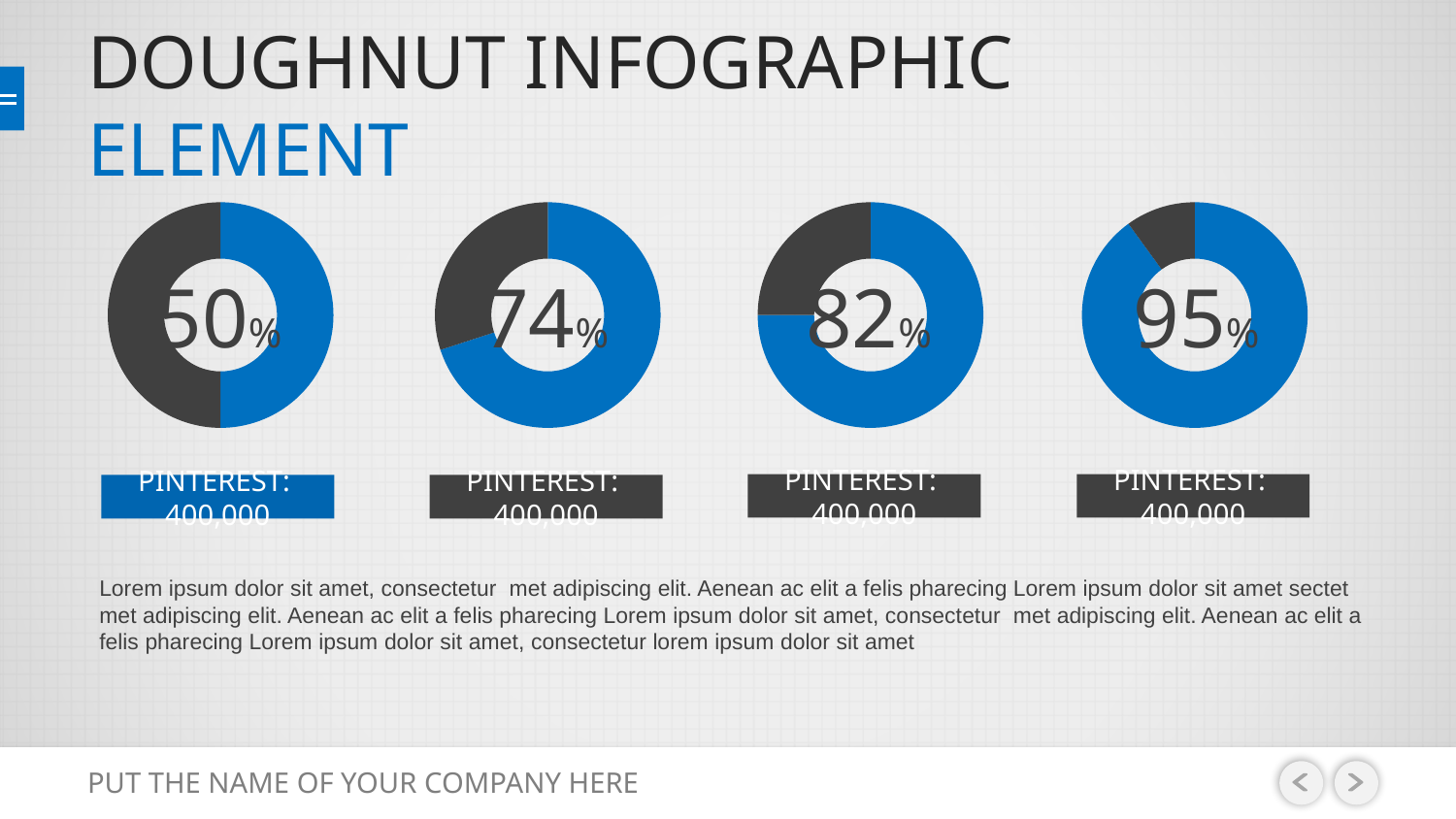
What percentage is shown in the centre of the leftmost doughnut chart? 50% What percentage is shown in the centre of the rightmost doughnut chart? 95% Which doughnut chart shows the lowest percentage? The leftmost one (50%) How many doughnut charts are on the slide? 4 What label appears in the box below each doughnut chart? PINTEREST: 400,000 What is the difference between the percentage in the rightmost doughnut chart and the leftmost doughnut chart? 45 percentage points What percentage is shown in the centre of the third doughnut chart from the left? 82% What percentage is shown in the centre of the second doughnut chart from the left? 74% Which is larger, the percentage in the second doughnut chart or the third doughnut chart? The third (82%) What kind of chart is used on this slide? Doughnut chart Do the percentages in the doughnut charts rise or fall from left to right across the slide? Rise Which doughnut chart shows the highest percentage? The rightmost one (95%)